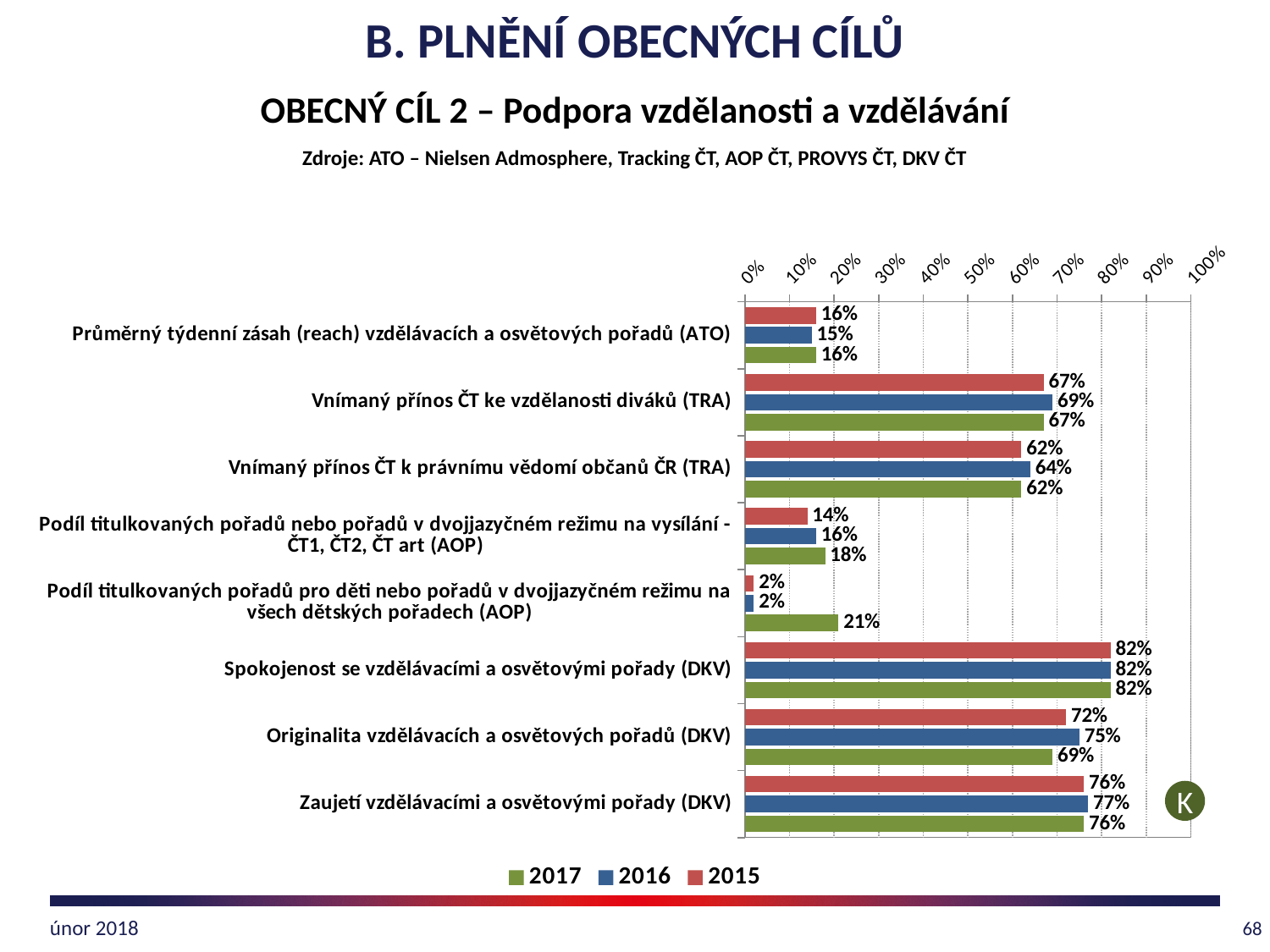
What type of chart is shown on the slide? bar chart What is the 2015 value for 'Vnímaný přínos ČT k právnímu vědomí občanů ČR (TRA)'? 62% What is the 2017 value for 'Podíl titulkovaných pořadů pro děti nebo pořadů v dvojjazyčném režimu na všech dětských pořadech (AOP)'? 21% What is the 2016 value for 'Originalita vzdělávacích a osvětových pořadů (DKV)'? 75% Which colour represents the 2015 series in the legend? red Is the 2016 value for 'Vnímaný přínos ČT ke vzdělanosti diváků (TRA)' greater or less than 60%? greater Which category has the lowest 2015 value? Podíl titulkovaných pořadů pro děti nebo pořadů v dvojjazyčném režimu na všech dětských pořadech (AOP) How many series does the legend list? 3 For 'Originalita vzdělávacích a osvětových pořadů (DKV)', which year has the larger value, 2016 or 2017? 2016 What is the difference between the 2017 and 2015 values for 'Podíl titulkovaných pořadů pro děti nebo pořadů v dvojjazyčném režimu na všech dětských pořadech (AOP)'? 19% Which category has the highest 2017 value? Spokojenost se vzdělávacími a osvětovými pořady (DKV) How many categories are plotted on the chart? 8